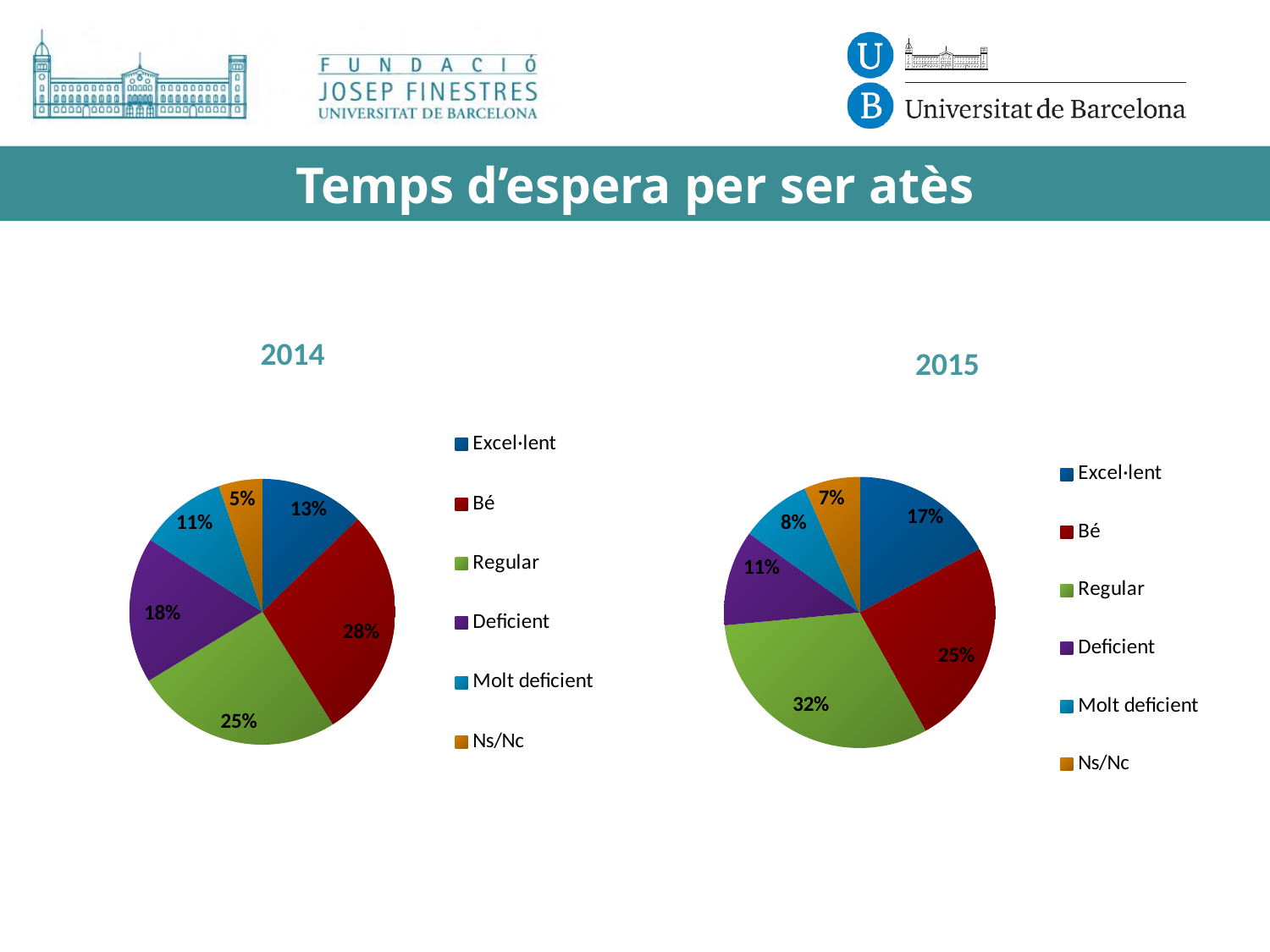
In the 2015 pie chart, what percentage is shown for Regular? 32% In the 2015 pie chart, what percentage is shown for Ns/Nc? 7% What is the title of the slide containing the two pie charts? Temps d'espera per ser atès In the 2014 pie chart, which is larger: Excel·lent or Molt deficient? Excel·lent In the 2014 pie chart, what is the combined share of Excel·lent and Bé? 41% In the 2015 pie chart, which category has the smallest slice? Ns/Nc In the 2014 pie chart, which category has the largest slice? Bé What type of chart is used for the 2014 data? Pie chart In the 2014 pie chart, what percentage is shown for Deficient? 18% How many categories does the legend of the 2015 pie chart list? 6 In the 2015 pie chart, what is the difference in percentage points between Regular and Bé? 7 In the 2014 pie chart, what percentage is shown for Bé? 28%